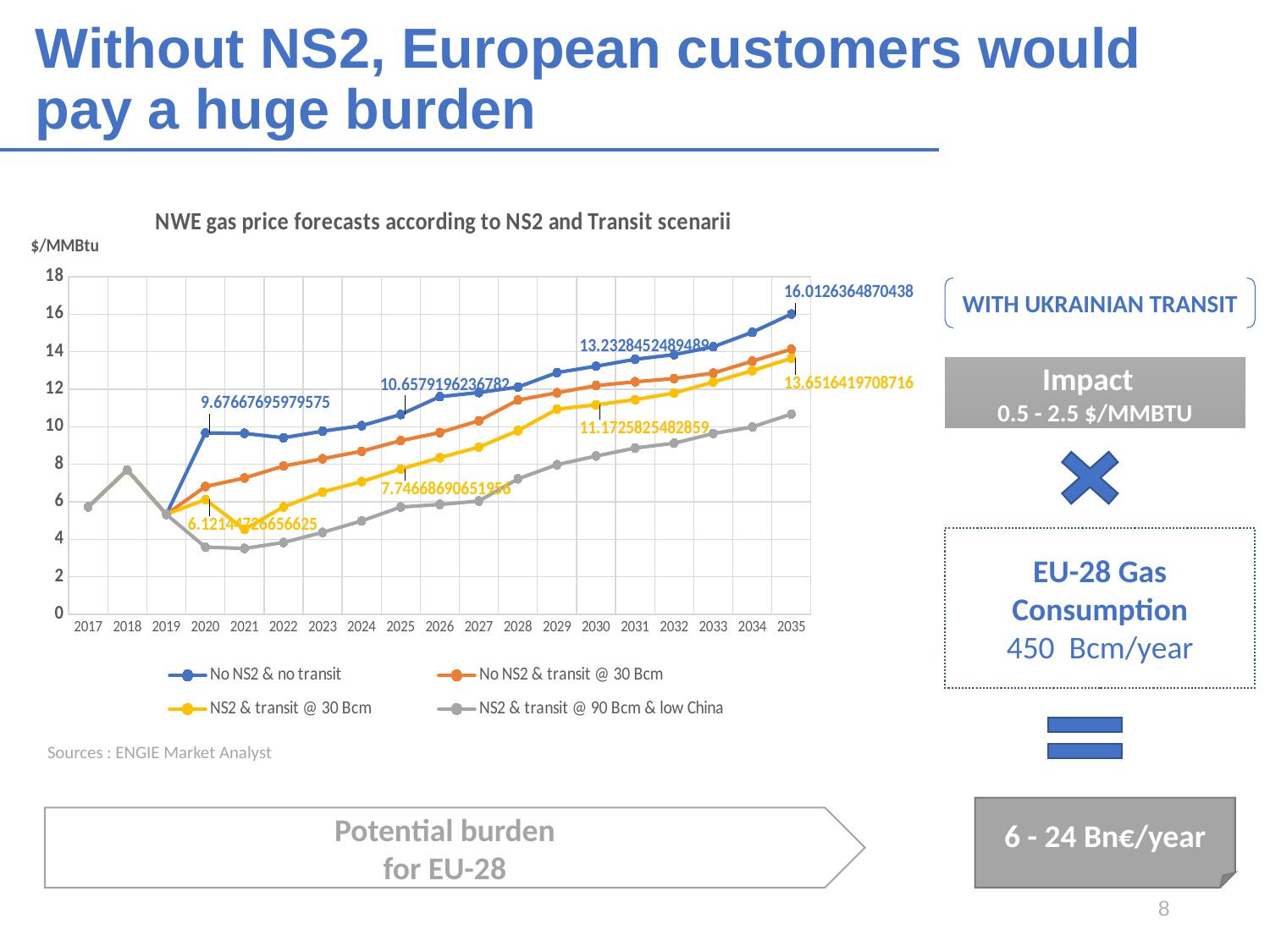
How many years are shown on the x axis of the chart? 19 What is the value for 'No NS2 & no transit' in 2035? 16.0126364870438 What is the value for 'No NS2 & no transit' in 2030? 13.2328452489489 Which series has the lowest value in 2035? NS2 & transit @ 90 Bcm & low China How many series does the legend of the chart list? 4 Is the 2035 value for 'NS2 & transit @ 90 Bcm & low China' greater or less than 10? greater What is the value for 'NS2 & transit @ 30 Bcm' in 2020? 6.12144726656625 What is the value for 'NS2 & transit @ 30 Bcm' in 2025? 7.74668690651956 In 2020, which is larger: 'No NS2 & no transit' or 'NS2 & transit @ 30 Bcm'? No NS2 & no transit What is the difference between the 2035 values of 'No NS2 & no transit' and 'NS2 & transit @ 30 Bcm'? 2.3609945161722 What kind of chart is shown on the slide? Line chart What unit is shown on the y axis of the chart? $/MMBtu